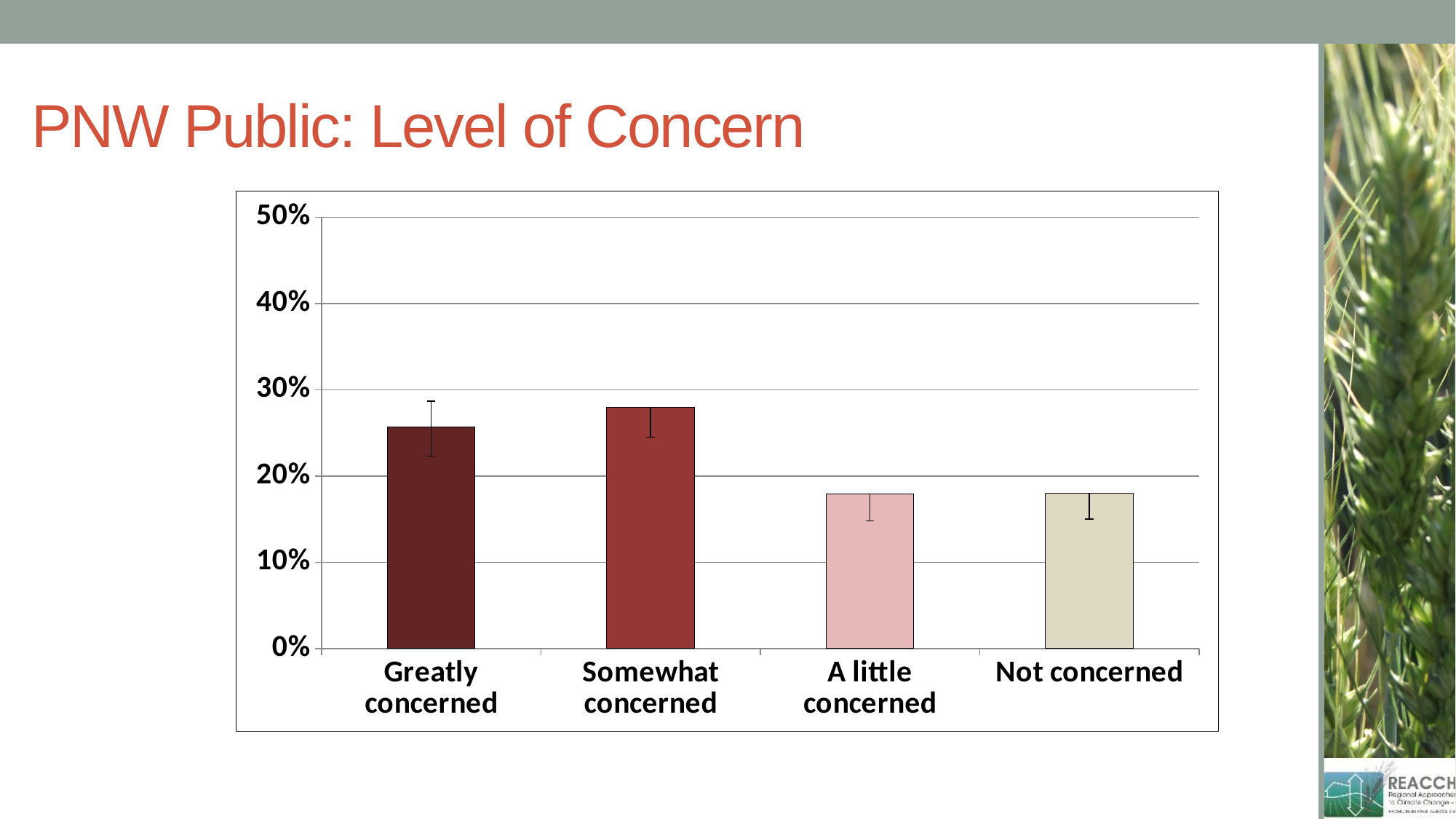
Which is larger, the value for Somewhat concerned or the value for Not concerned? Somewhat concerned What is the title of the slide containing the chart? PNW Public: Level of Concern Which category has the highest value in the chart? Somewhat concerned What kind of chart is shown on the slide? bar chart Is the value for A little concerned greater or less than 20%? less How many categories are shown on the x axis of the chart? 4 Is the value for Somewhat concerned greater or less than 30%? less Which is larger, the value for Greatly concerned or the value for A little concerned? Greatly concerned What is the highest value shown on the y axis of the chart? 50% Is the value for Greatly concerned greater or less than 20%? greater